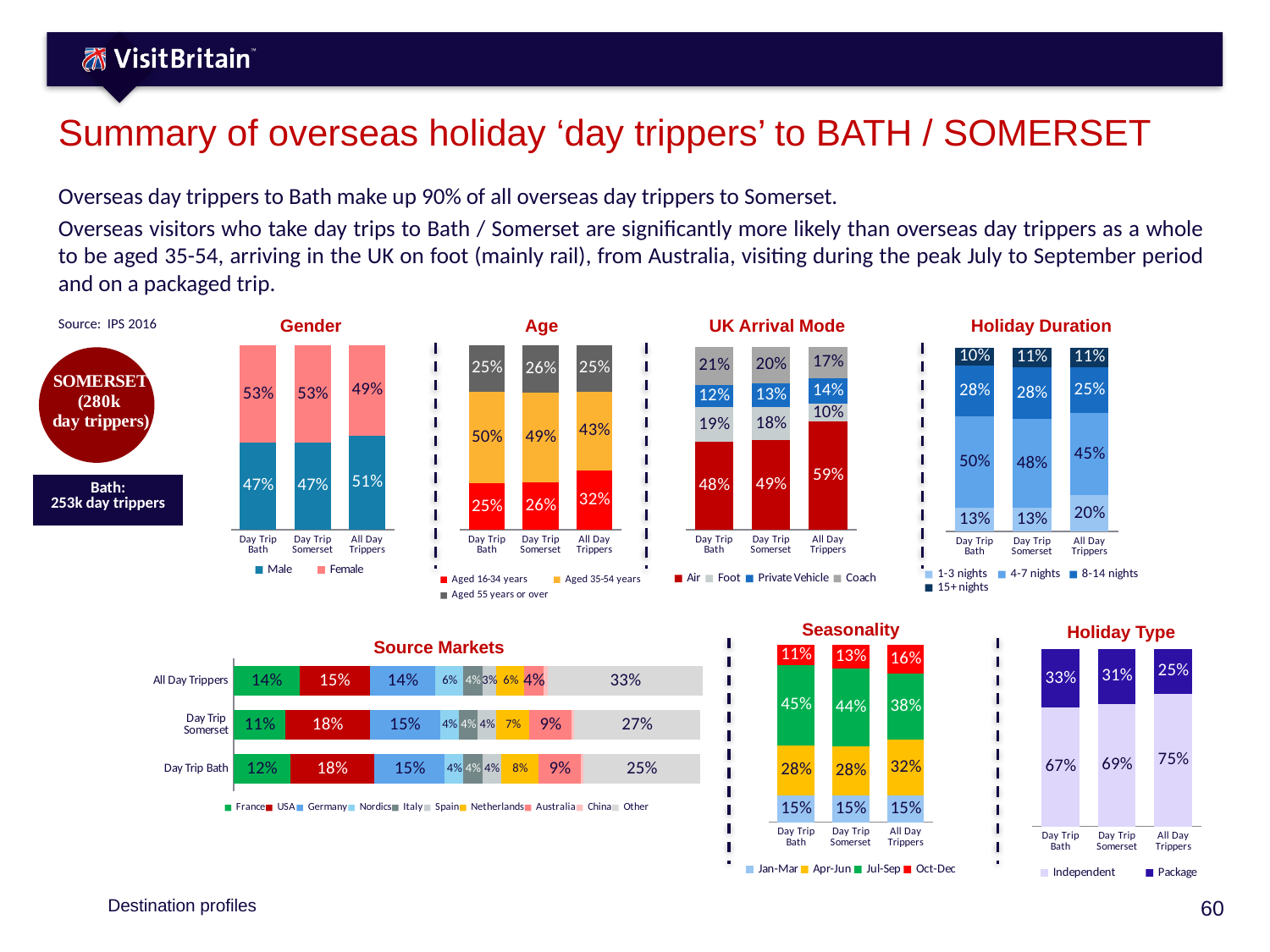
In the Age chart, what percentage of All Day Trippers are Aged 16-34 years? 32% In the Holiday Duration chart, what is the difference between the 4-7 nights share for Day Trip Bath and for All Day Trippers? 5% In the UK Arrival Mode chart, which category has the highest share arriving by Air? All Day Trippers In the Source Markets chart, is the Australia share larger for Day Trip Bath or for All Day Trippers? Day Trip Bath What type of chart is the Source Markets chart? Stacked bar chart In the Seasonality chart, what percentage of Day Trip Somerset visitors visit in Jul-Sep? 44% In the Holiday Duration chart, which category has the lowest share of 1-3 nights stays? Day Trip Bath and Day Trip Somerset (both 13%) In the Holiday Type chart, what percentage of All Day Trippers are on a Package trip? 25% How many series does the legend of the Seasonality chart list? 4 In the UK Arrival Mode chart, what percentage of Day Trip Somerset visitors arrive by Air? 49% In the Gender chart, what percentage of Day Trip Bath visitors are Male? 47% In the Source Markets chart, what percentage of Day Trip Bath visitors come from the USA? 18%